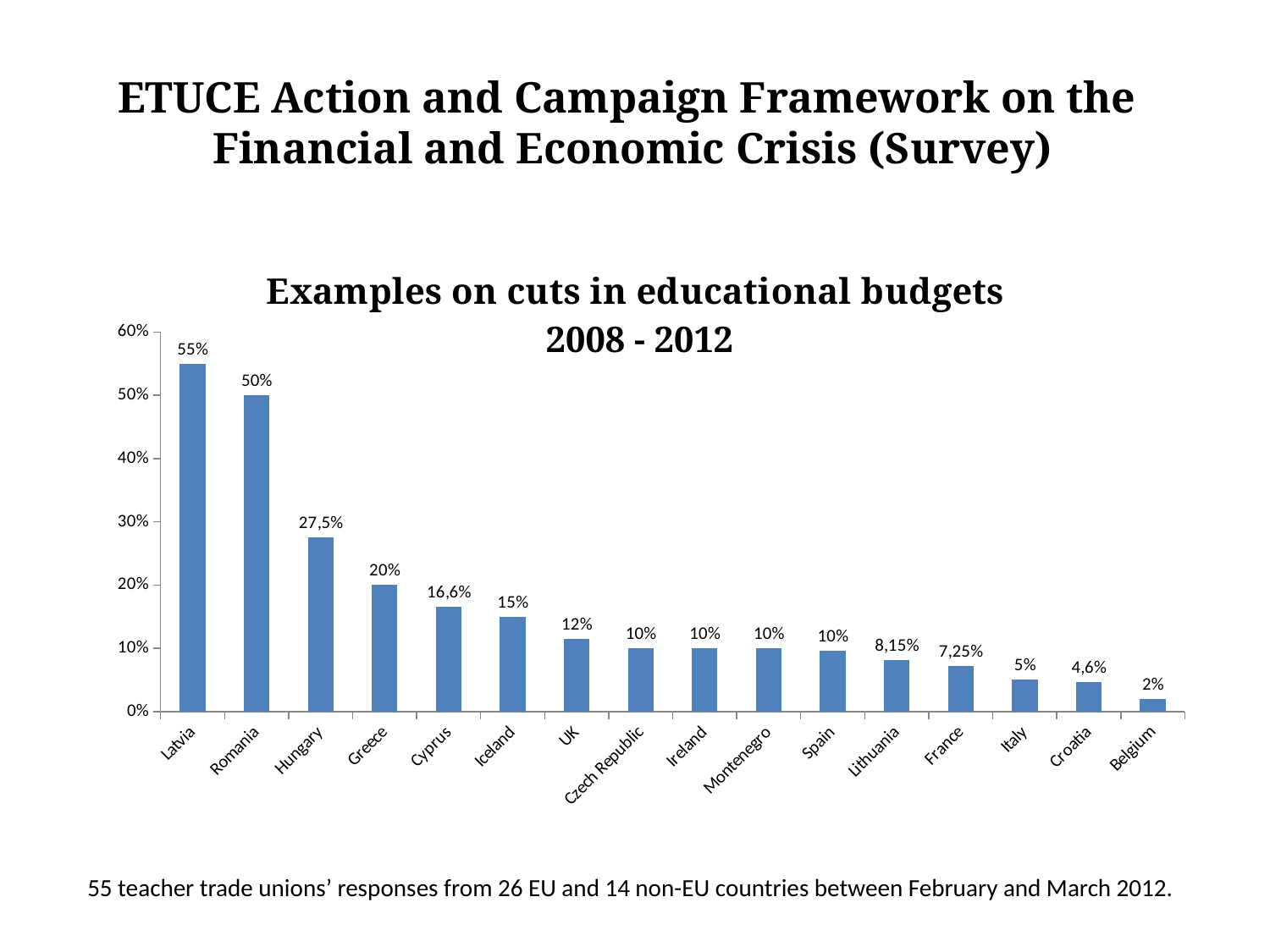
What is the difference between the values for Latvia and Romania? 5% What is the value for Latvia? 55% What is the difference between the values for Greece and Cyprus? 3,4% Is the value for Hungary greater or less than 30%? less What is the value for Hungary? 27,5% Which is larger, the value for Iceland or the value for UK? Iceland What is the value for Lithuania? 8,15% Which country has the lowest value? Belgium What is the title of the chart? Examples on cuts in educational budgets 2008 - 2012 How many countries are shown on the chart? 16 Which country has the highest value? Latvia What kind of chart is shown on the slide? bar chart